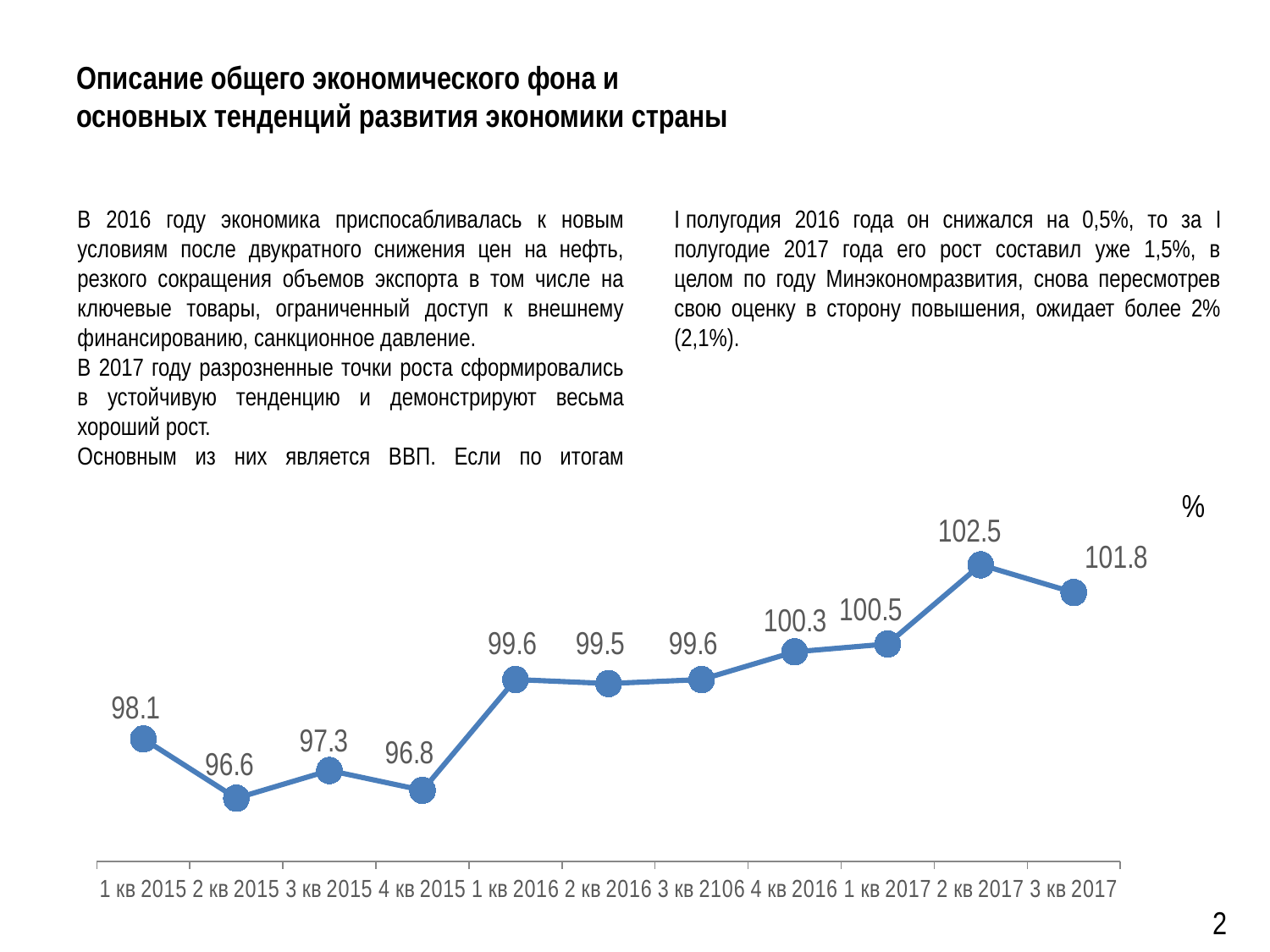
What is the difference between the values for 1 кв 2016 and 4 кв 2015? 2.8 How many data points are plotted on the chart? 11 Which is larger, the value for 3 кв 2015 or the value for 4 кв 2015? 3 кв 2015 What is the value for 4 кв 2016? 100.3 Do the values generally rise or fall from 4 кв 2015 to 2 кв 2017? rise What is the value for 1 кв 2015? 98.1 What is the value for 3 кв 2017? 101.8 Which quarter has the lowest value on the chart? 2 кв 2015 What type of chart is shown on the slide? line chart Which quarter has the highest value on the chart? 2 кв 2017 What is the difference between the values for 2 кв 2017 and 3 кв 2017? 0.7 What unit label is shown at the top right of the chart? %